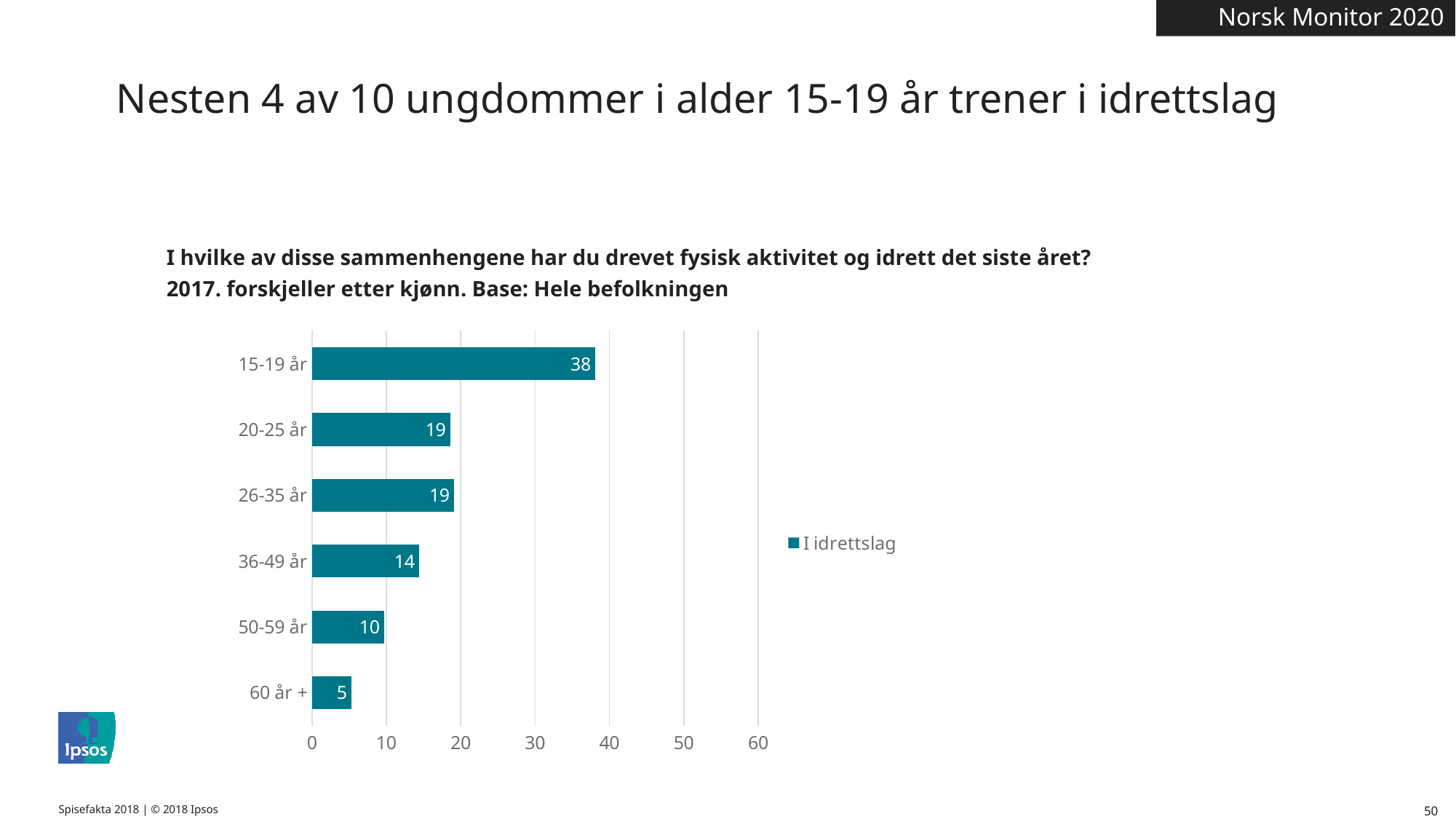
Which age group has the lowest value? 60 år + How many series does the legend list? 1 Which age group has the highest value? 15-19 år What is the difference between the values for 50-59 år and 60 år +? 5 What kind of chart is shown on the slide? Bar chart What is the value for the 36-49 år age group? 14 What is the value for the 15-19 år age group? 38 How many age groups are shown in the chart? 6 What is the value for the 60 år + age group? 5 What is the name of the series shown in the legend? I idrettslag Which is larger, the value for 36-49 år or the value for 50-59 år? 36-49 år What is the difference between the values for 15-19 år and 20-25 år? 19